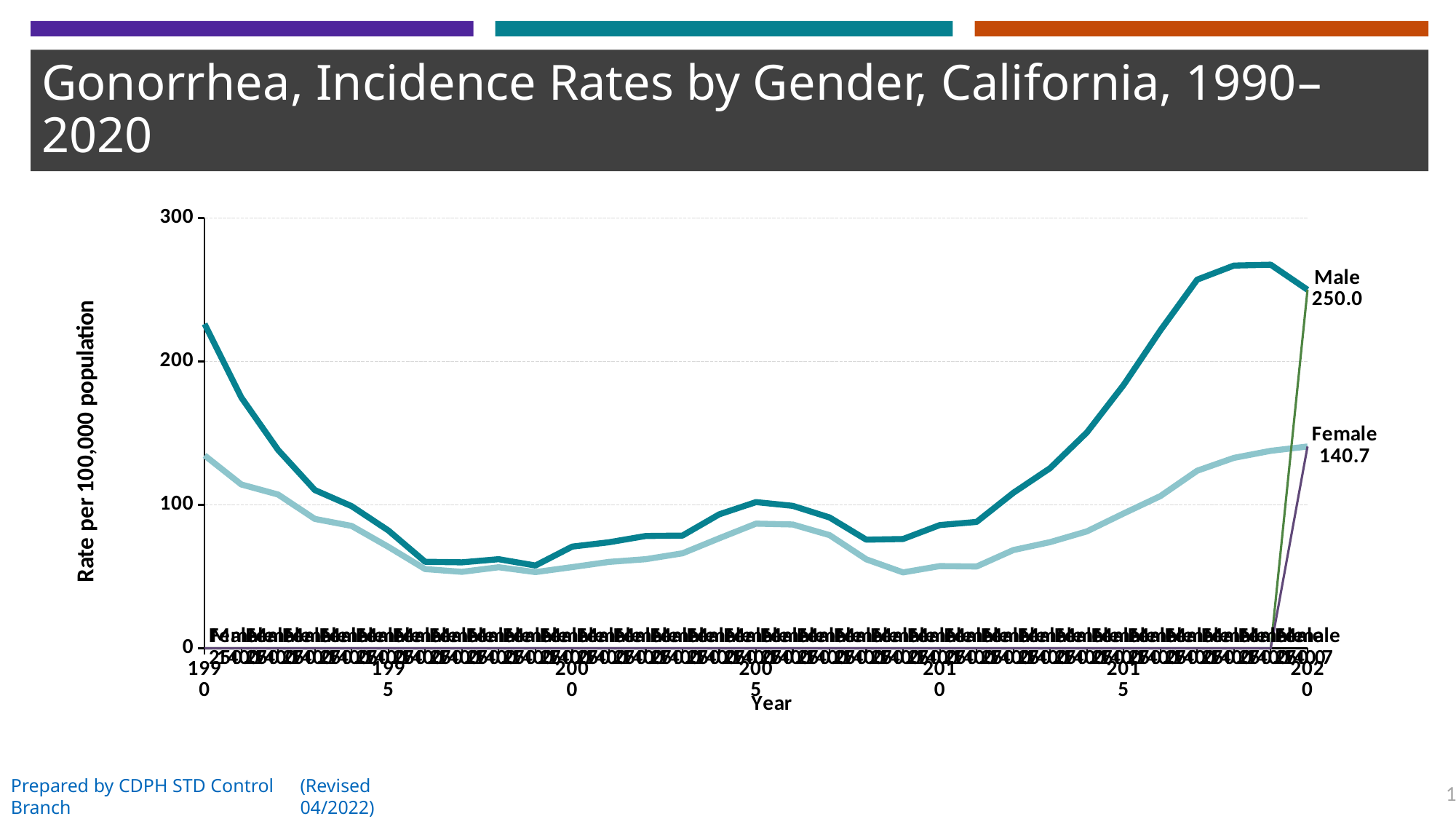
How many series are plotted on the chart? 2 Is the male rate in 1990 greater or less than 200? greater Is the male rate in 2015 greater or less than 100? greater What kind of chart is shown on the slide? line chart What is the male gonorrhea incidence rate in 2020? 250.0 Is the female rate in 1990 greater or less than 100? greater What is the difference between the male and female rates in 2020? 109.3 What is the title of the vertical axis? Rate per 100,000 population Does the male rate rise or fall between 2010 and 2019? rise What is the female gonorrhea incidence rate in 2020? 140.7 In 2020, which series has the higher rate, Male or Female? Male